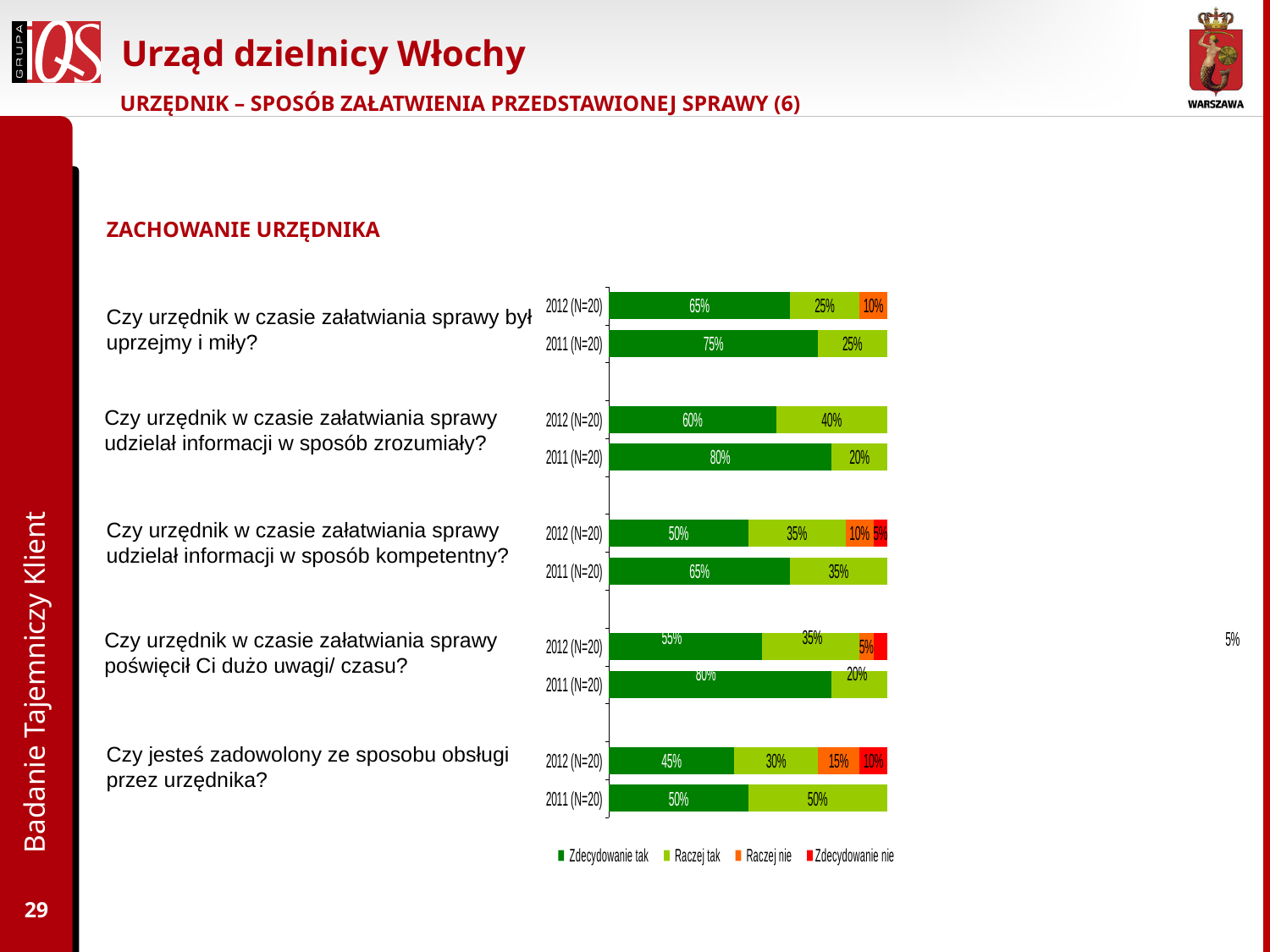
What share answered "Zdecydowanie tak" in 2012 (N=20) for "Czy urzędnik w czasie załatwiania sprawy był uprzejmy i miły?"? 65% What share answered "Zdecydowanie nie" in 2012 (N=20) for "Czy urzędnik w czasie załatwiania sprawy udzielał informacji w sposób kompetentny?"? 5% Which legend entry is shown in red? Zdecydowanie nie For "Czy urzędnik w czasie załatwiania sprawy udzielał informacji w sposób zrozumiały?", what is the difference between the "Zdecydowanie tak" share in 2011 (N=20) and in 2012 (N=20)? 20% What kind of chart is shown on the slide? Stacked bar chart What share answered "Raczej tak" in 2011 (N=20) for "Czy urzędnik w czasie załatwiania sprawy udzielał informacji w sposób zrozumiały?"? 20% How many series does the legend list? 4 What share answered "Raczej nie" in 2012 (N=20) for "Czy jesteś zadowolony ze sposobu obsługi przez urzędnika?"? 15% How many survey questions are shown in the chart? 5 Which question has the lowest "Zdecydowanie tak" share in 2012 (N=20)? Czy jesteś zadowolony ze sposobu obsługi przez urzędnika? What is the total of the "Zdecydowanie tak" and "Raczej tak" shares in 2012 (N=20) for "Czy urzędnik w czasie załatwiania sprawy poświęcił Ci dużo uwagi/ czasu?"? 90% For "Czy jesteś zadowolony ze sposobu obsługi przez urzędnika?", which year has the larger "Zdecydowanie tak" share, 2012 (N=20) or 2011 (N=20)? 2011 (N=20)